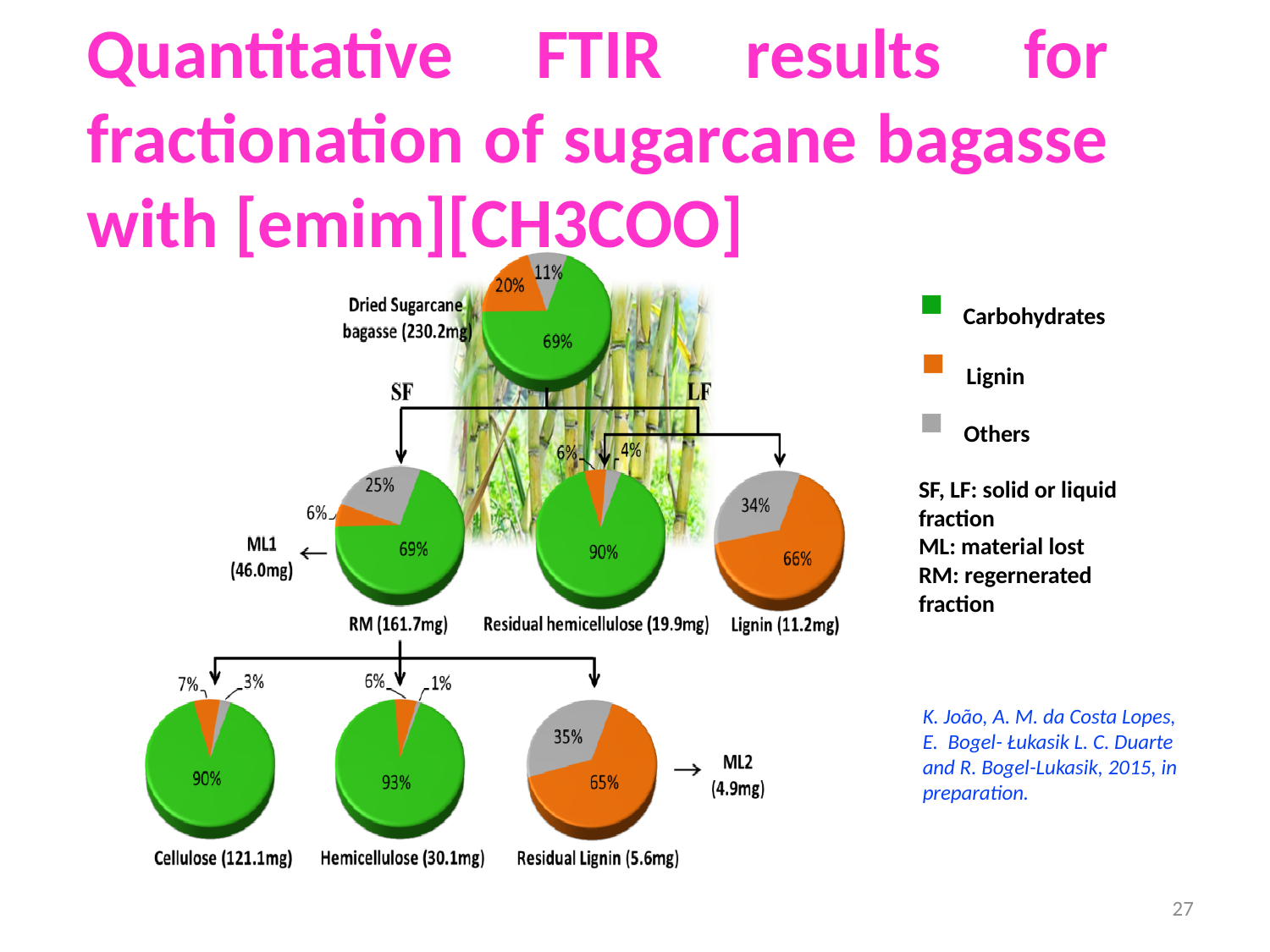
In the Residual hemicellulose (19.9mg) pie chart, which category has the largest share? Carbohydrates In the Residual Lignin (5.6mg) pie chart, what share is Others? 35% In the Hemicellulose (30.1mg) pie chart, what share is Carbohydrates? 93% What kind of charts are shown on the slide? Pie charts In the Dried Sugarcane bagasse pie chart, what share is Lignin? 20% In the Cellulose (121.1mg) pie chart, which category has the smallest share? Others Which is larger: the Lignin share in the Dried Sugarcane bagasse pie chart or the Lignin share in the RM (161.7mg) pie chart? Dried Sugarcane bagasse How many categories does the legend list? 3 What is the difference between the Carbohydrates share in the Hemicellulose (30.1mg) pie chart and the Carbohydrates share in the Cellulose (121.1mg) pie chart? 3%